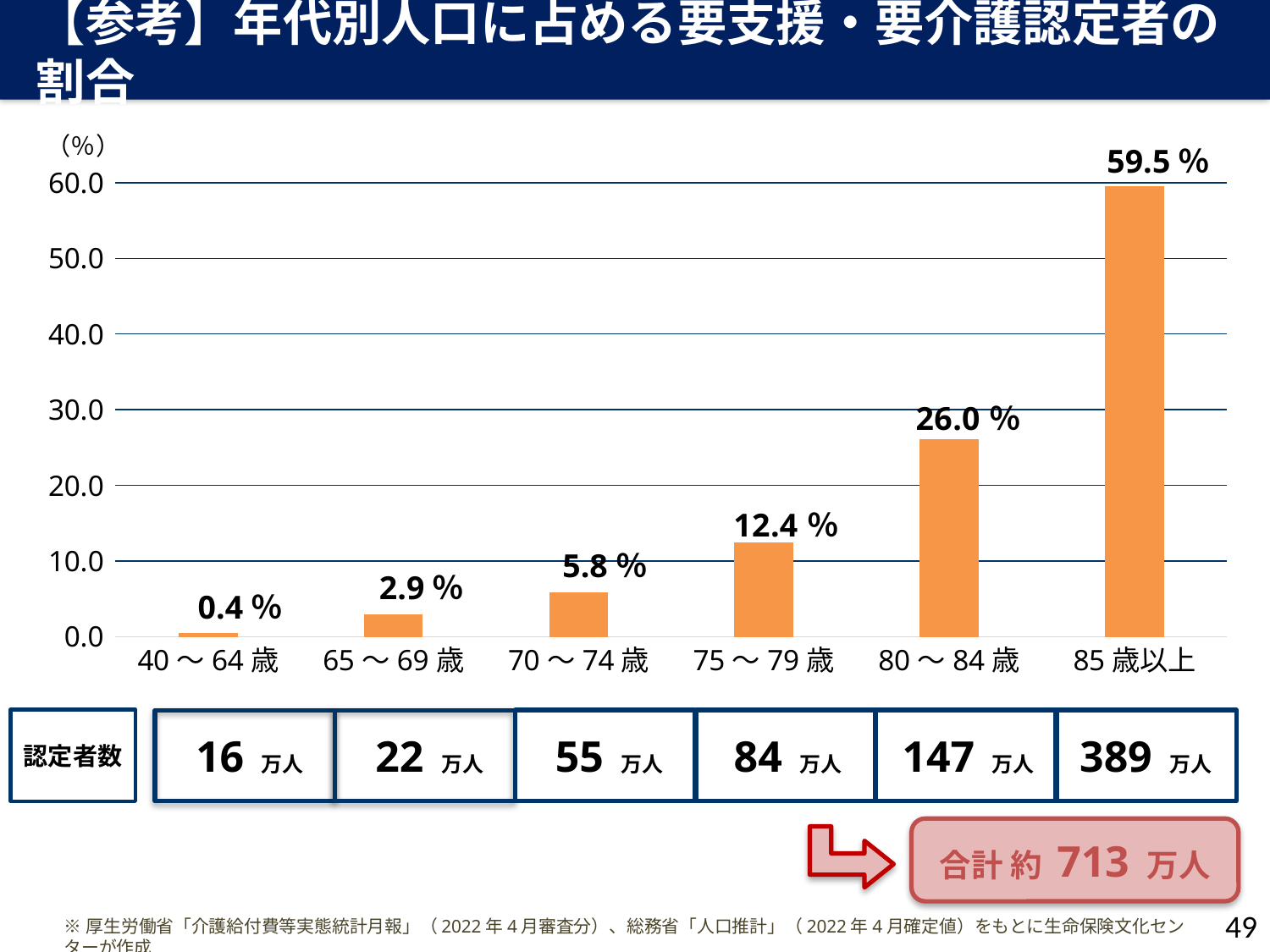
What unit is shown at the top of the vertical axis? (%) What is the value for the 85歳以上 age group? 59.5 % Which age group has the highest value? 85歳以上 Is the value for 80～84歳 greater or less than 30.0? less How many age groups are shown on the x axis? 6 What is the value for the 40～64歳 age group? 0.4 % What is the value for the 75～79歳 age group? 12.4 % Which age group has the lowest value? 40～64歳 What is the difference between the values for 80～84歳 and 75～79歳? 13.6 % What kind of chart is shown on the slide? bar chart Do the values rise or fall as the age groups move from left to right along the x axis? rise Which is larger, the value for 70～74歳 or the value for 65～69歳? 70～74歳